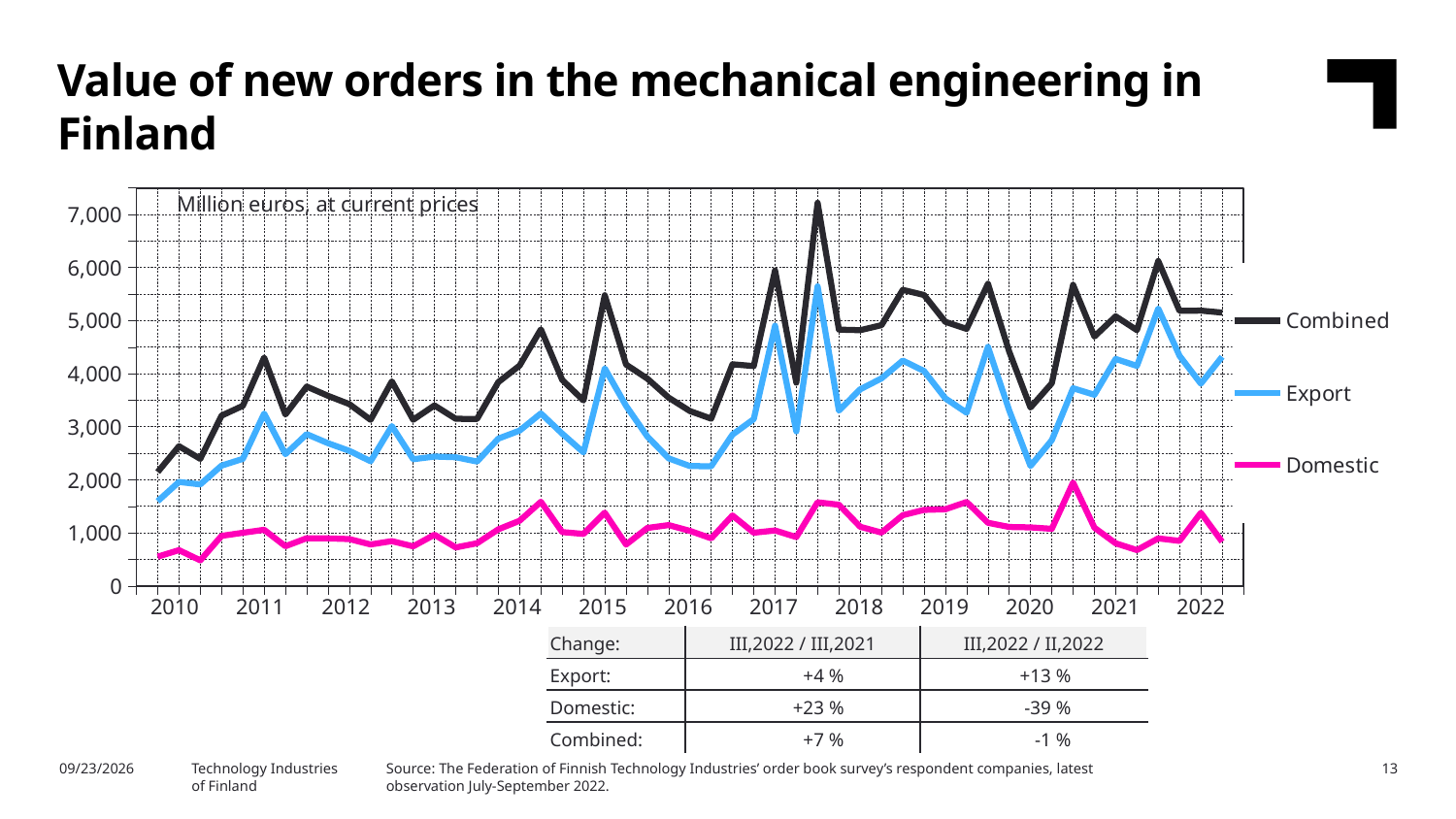
Is the peak value of the Combined series in 2017 greater or less than 6,000? greater Are the Domestic series values greater or less than 3,000 across the whole period? less How many years are labelled on the x axis? 13 How many series does the legend list? 3 Which series are listed in the legend? Combined, Export, Domestic What unit is stated for the values in the chart? Million euros, at current prices Which series has the highest values throughout the chart? Combined Is the Export value at the start of 2010 greater or less than 2,000? less Which is larger in 2022, the Export series or the Domestic series? Export What kind of chart is shown on the slide? line chart Which series has the lowest values throughout the chart? Domestic